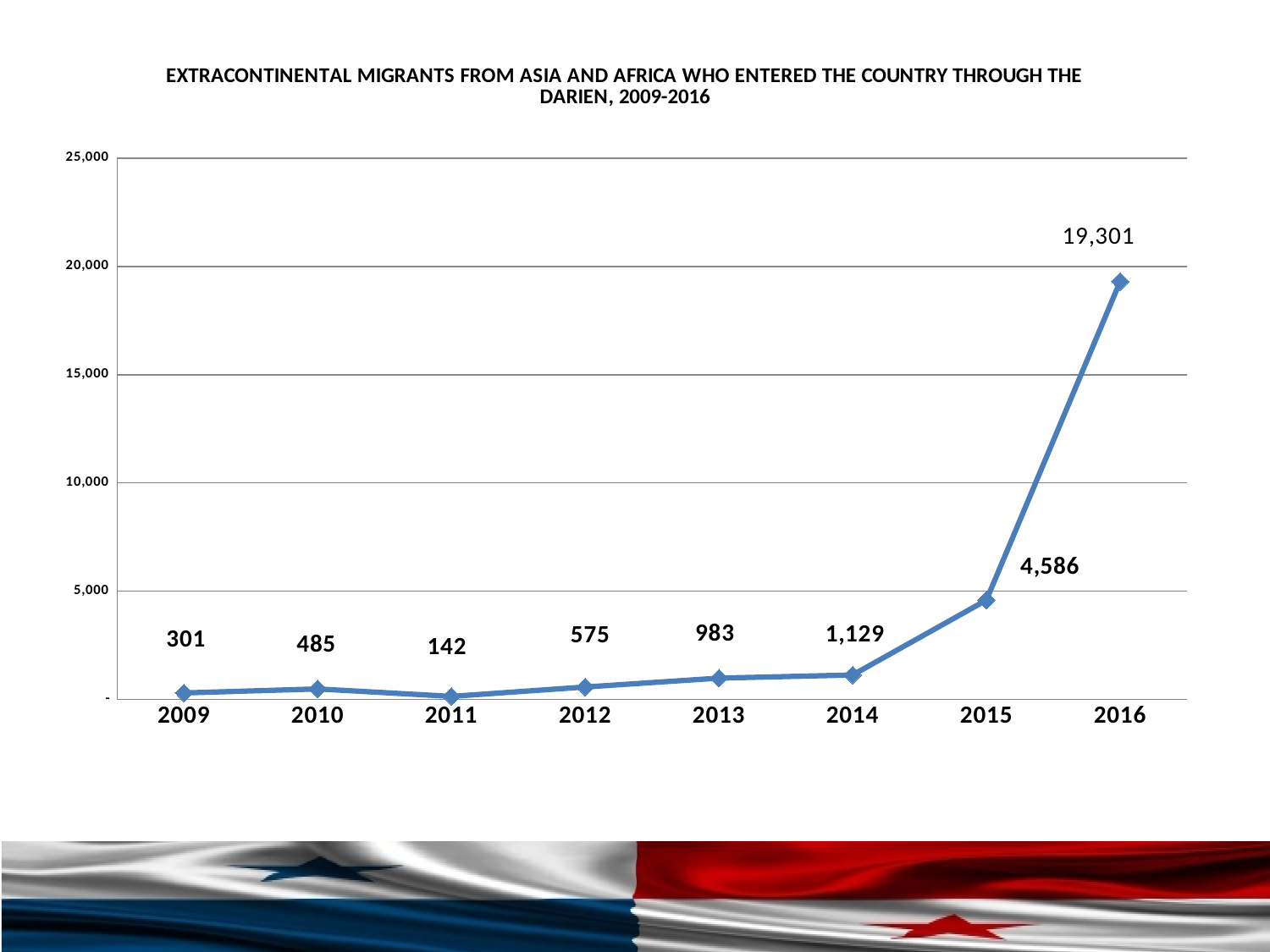
What is the value for 2016? 19,301 What is the difference between the values for 2010 and 2009? 184 Which year has the highest value? 2016 Do the values rise or fall from 2014 to 2016? rise What is the difference between the values for 2016 and 2015? 14,715 What kind of chart is shown on the slide? line chart Is the value for 2015 greater or less than 5,000? less How many years are plotted on the chart? 8 What is the value for 2011? 142 Which is larger, the value for 2012 or the value for 2013? 2013 What is the value for 2014? 1,129 Which year has the lowest value? 2011